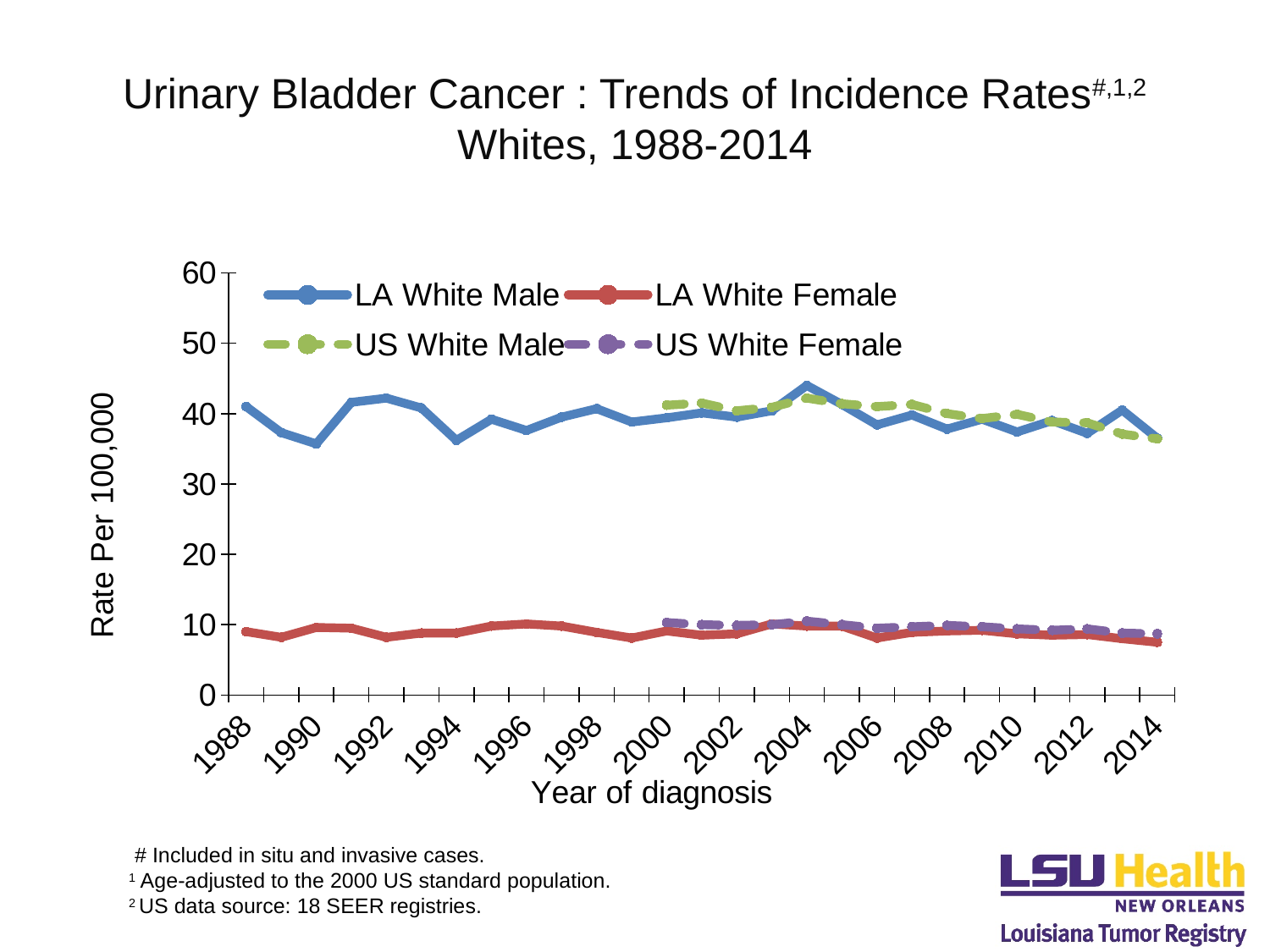
Is the value for LA White Male in 2004 greater or less than 40? greater How many series does the legend list? 4 In 2000, which is larger: the value for LA White Male or the value for LA White Female? LA White Male What is the label of the y-axis? Rate Per 100,000 Do the values for LA White Female rise or fall from 2008 to 2014? fall What is the label of the x-axis? Year of diagnosis What kind of chart is shown on the slide? Line chart Is the value for LA White Male in 1988 greater or less than 30? greater Is the value for US White Female in 2000 greater or less than 20? less Do the values for US White Male rise or fall from 2004 to 2014? fall